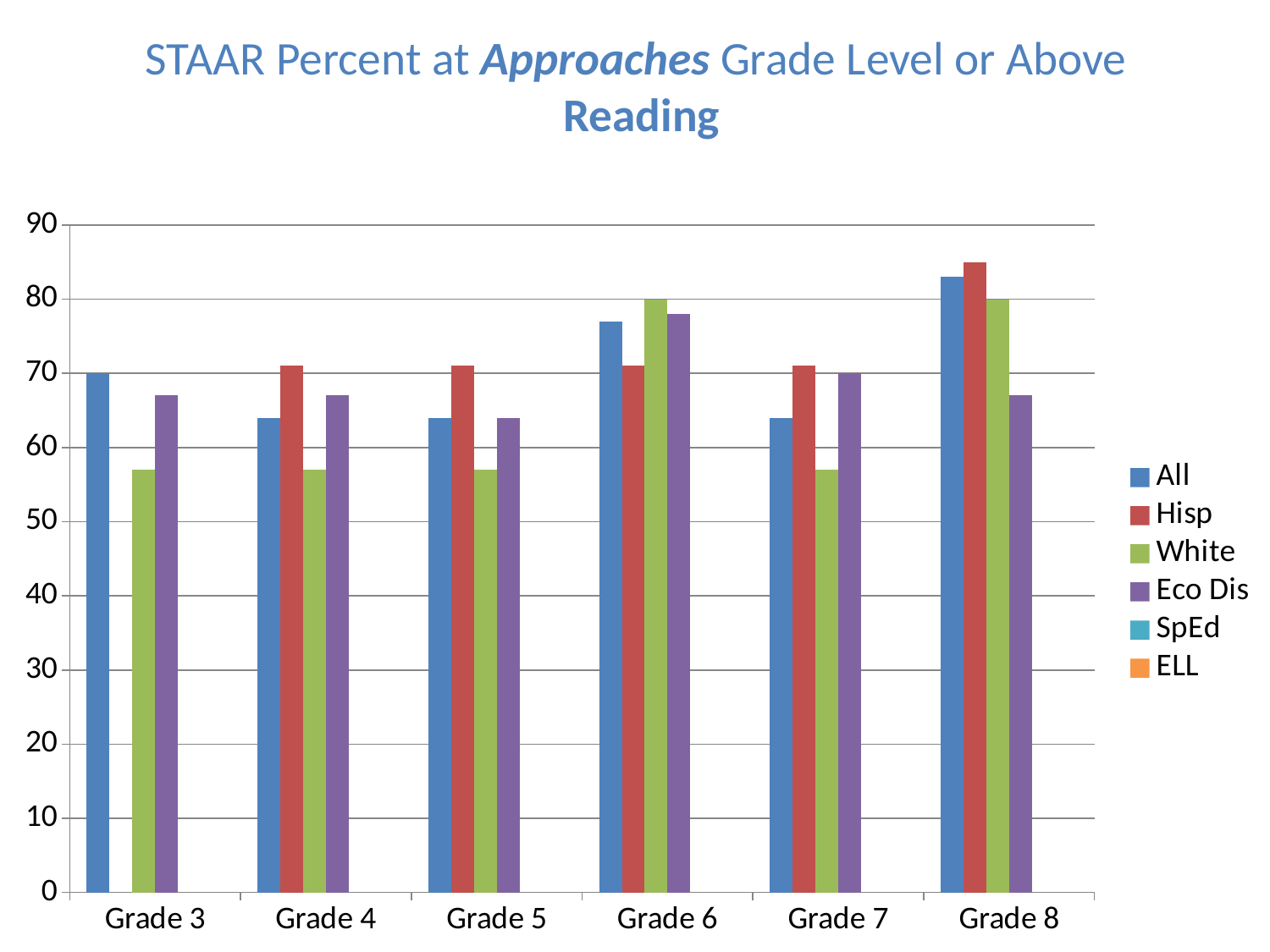
Is the value for White in Grade 4 greater or less than 60? less What is the value for Eco Dis in Grade 7? 70 Which series in the legend has no visible bars in Grade 3? Hisp, SpEd, ELL Which grade has the lowest value for Eco Dis? Grade 5 What is the value for All in Grade 3? 70 Which grade has the highest value for All? Grade 8 Is the value for Hisp in Grade 8 greater or less than 80? greater In Grade 6, which is larger, the value for White or the value for Hisp? White How many grade categories are shown on the x axis? 6 What is the value for White in Grade 6? 80 How many series does the legend list? 6 What kind of chart is shown on the slide? bar chart